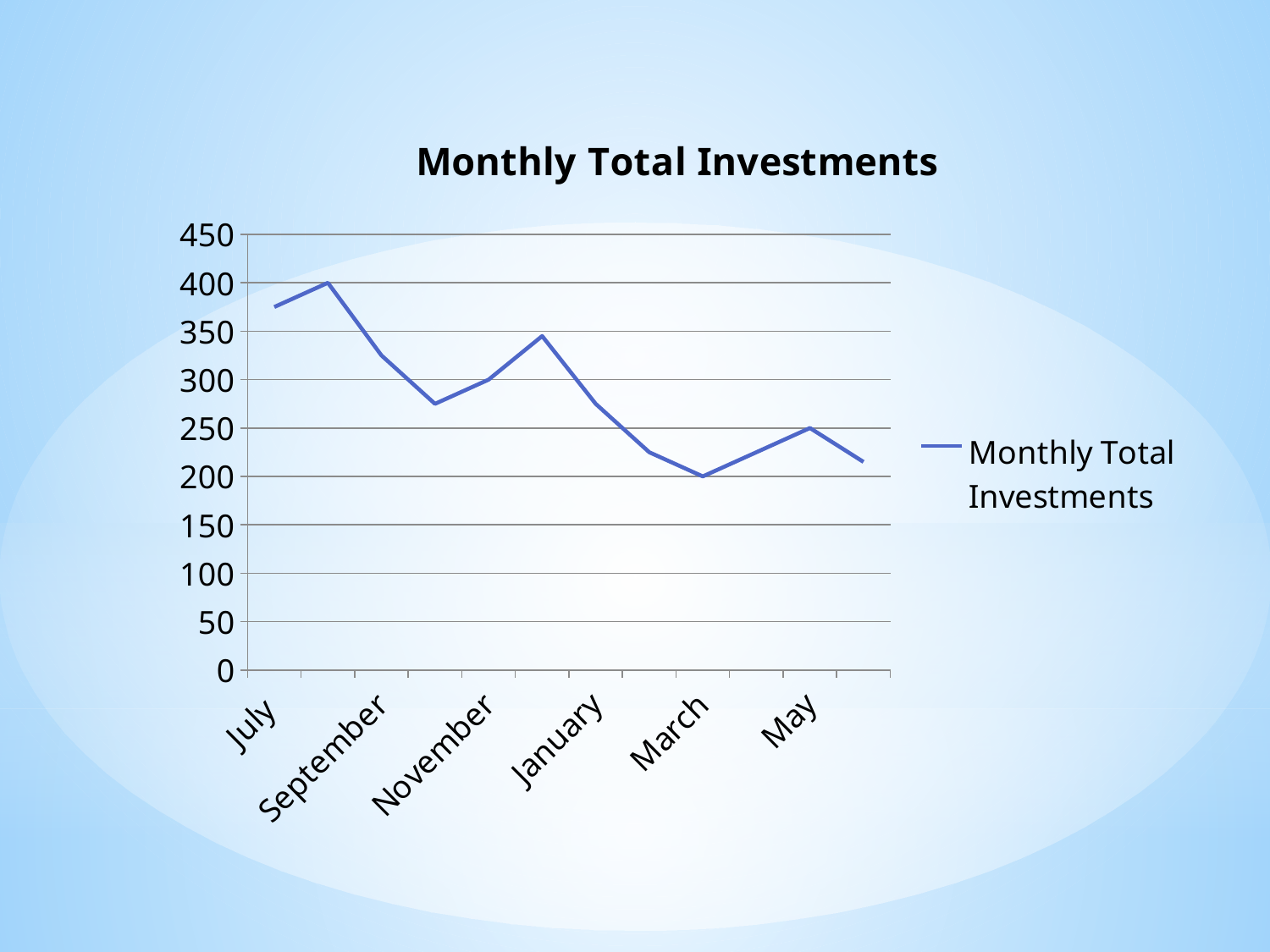
What kind of chart is shown on the slide? line chart What is the title of the chart? Monthly Total Investments Is the value for July greater or less than 350? greater Which month has the lowest value? March Which is larger, the value for July or the value for March? July Is the value for January greater or less than 300? less Is the value for September greater or less than 350? less Overall, do the values rise or fall from July to the end of the period? fall How many series does the legend list? 1 What is the value for May? 250 What is the value for March? 200